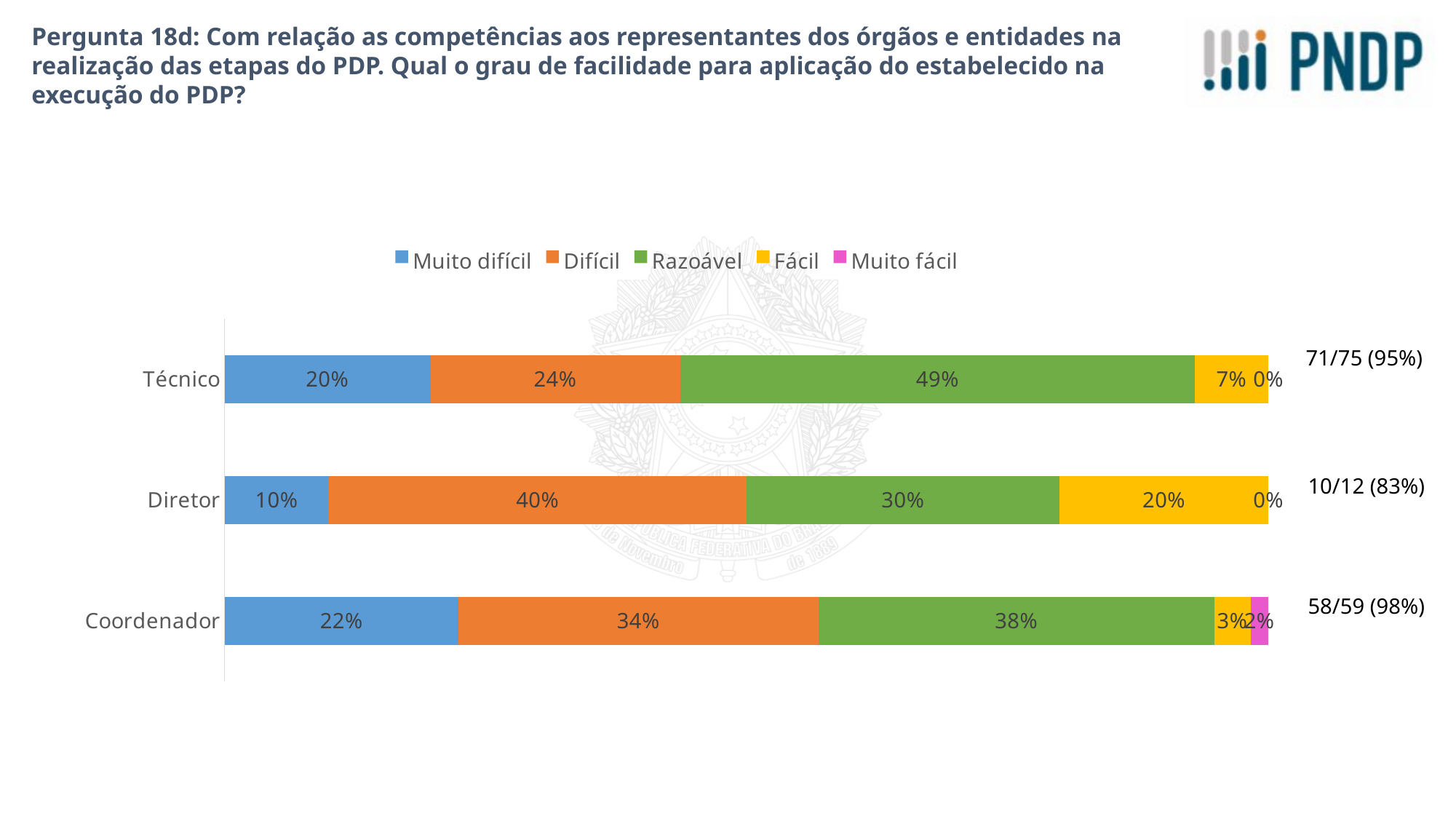
What response count annotation is shown next to the Coordenador bar? 58/59 (98%) Which category has the lowest Muito difícil value? Diretor What is the Muito fácil value for Coordenador? 2% What kind of chart is shown on the slide? Stacked bar chart What is the Difícil value for Diretor? 40% How many series does the legend list? 5 What is the Razoável value for Técnico? 49% Which category has the highest Difícil value? Diretor Which is larger: the Muito difícil value for Coordenador or for Técnico? Coordenador How many categories are shown on the vertical axis? 3 What is the difference between the Razoável values for Técnico and Diretor? 19% What is the Fácil value for Diretor? 20%